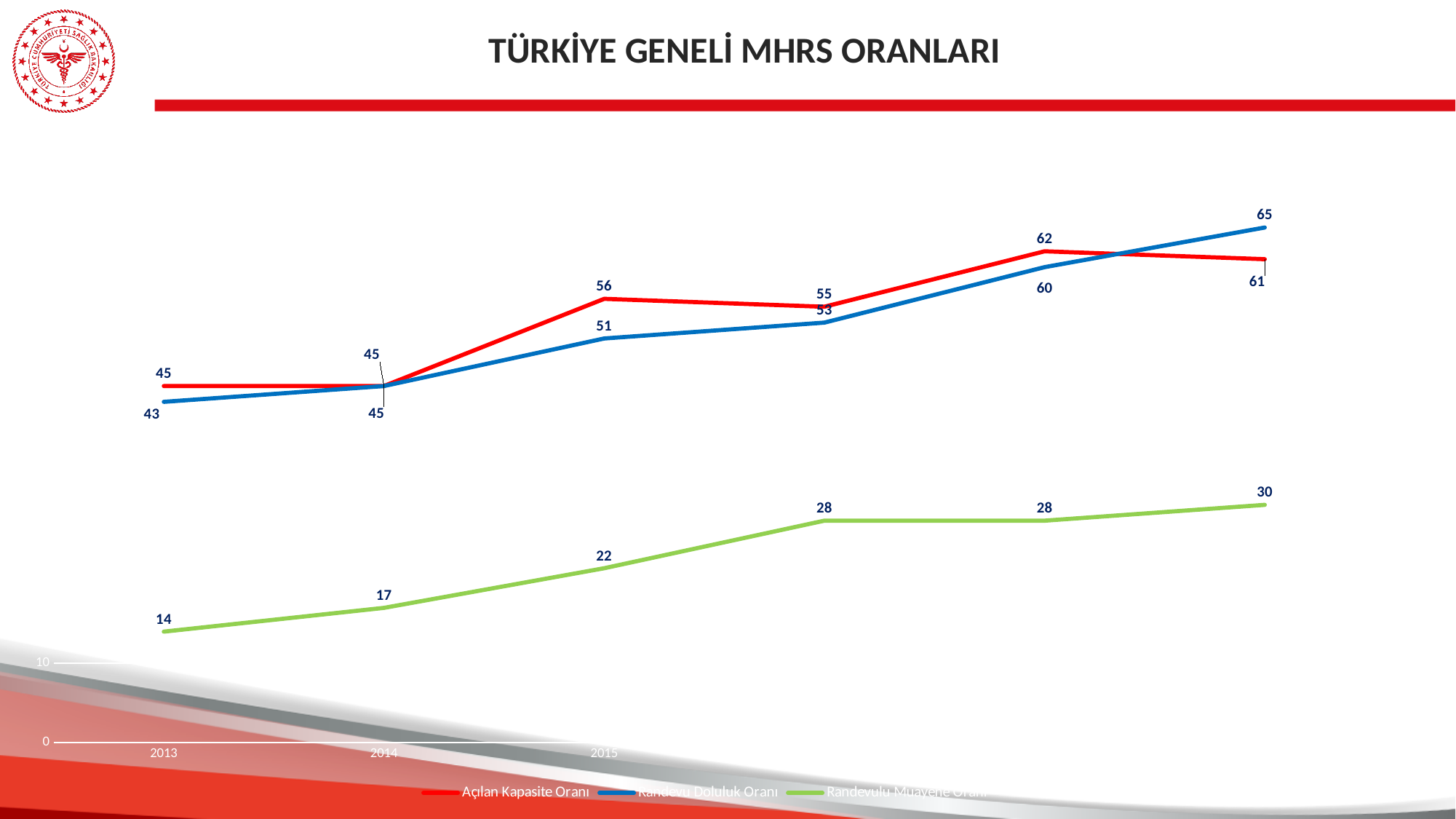
Which is larger in 2013: Açılan Kapasite Oranı or Randevulu Muayene Oranı? Açılan Kapasite Oranı What kind of chart is shown on the slide? line chart Does the Randevu Doluluk Oranı line rise or fall from left to right? rise What is the title of the chart on the slide? TÜRKİYE GENELİ MHRS ORANLARI How many data points does each line have? 6 What is the highest value reached by the Randevu Doluluk Oranı line? 65 What is the value of Açılan Kapasite Oranı in 2015? 56 How many series does the legend list? 3 What is the lowest value on the Randevulu Muayene Oranı line? 14 What is the difference between Açılan Kapasite Oranı and Randevu Doluluk Oranı in 2015? 5 What is the value of Randevulu Muayene Oranı in 2014? 17 What is the value of Randevu Doluluk Oranı in 2013? 43